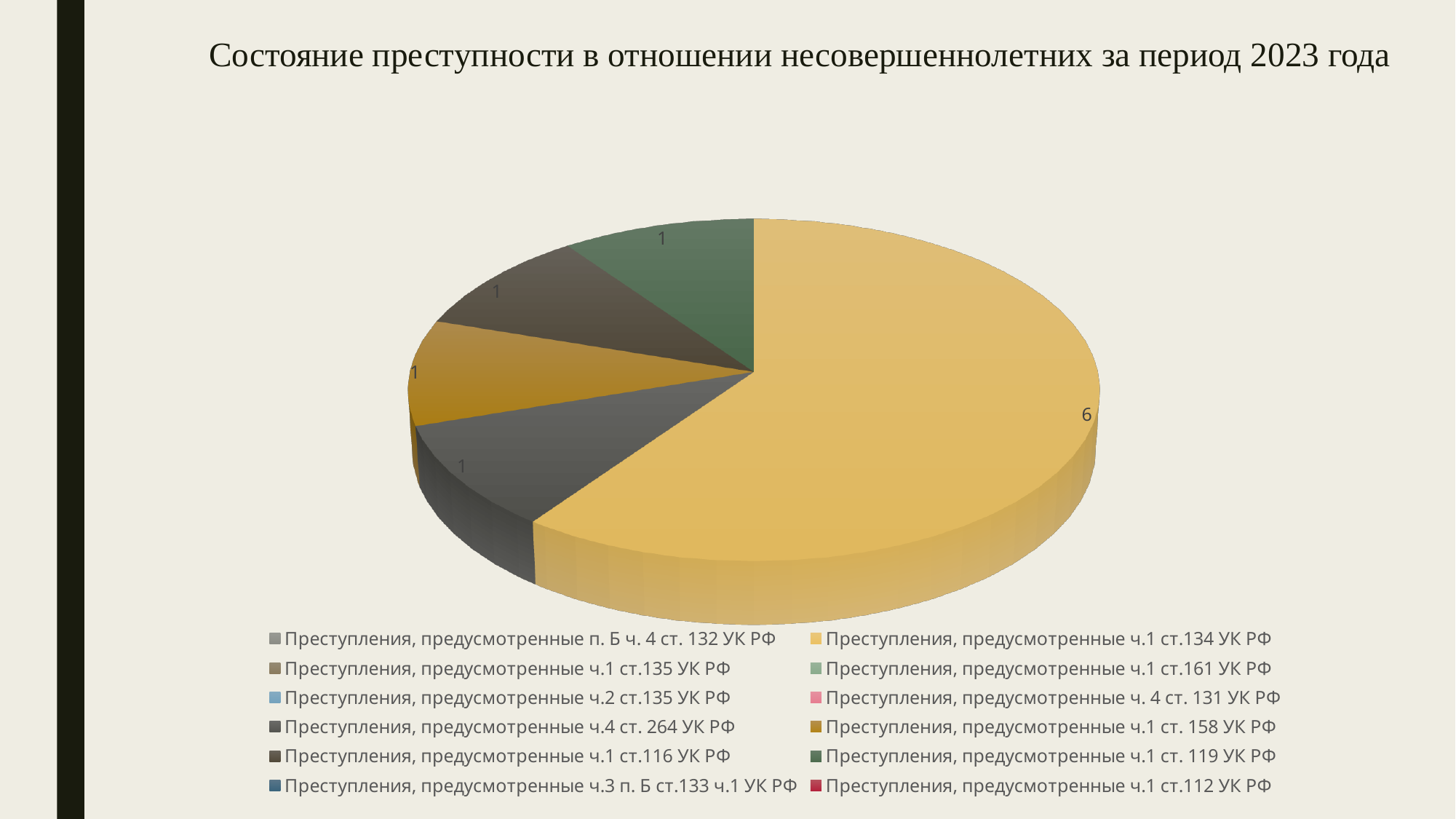
How many slices with data labels are visible in the pie? 5 What is the value for Преступления, предусмотренные ч.4 ст. 264 УК РФ? 1 Which is larger: the value for ч.1 ст.134 УК РФ or the value for ч.1 ст. 119 УК РФ? ч.1 ст.134 УК РФ What share of the labelled total does the slice for ч.1 ст.134 УК РФ represent? 60% What is the title of the chart? Состояние преступности в отношении несовершеннолетних за период 2023 года What is the difference between the value for ч.1 ст.134 УК РФ and the value for ч.1 ст.116 УК РФ? 5 Which category has the largest slice of the pie? Преступления, предусмотренные ч.1 ст.134 УК РФ What is the value for Преступления, предусмотренные ч.1 ст.134 УК РФ? 6 What kind of chart is shown on the slide? pie chart What is the value for Преступления, предусмотренные ч.1 ст. 158 УК РФ? 1 What is the value for Преступления, предусмотренные ч.1 ст. 119 УК РФ? 1 How many entries does the legend list? 12